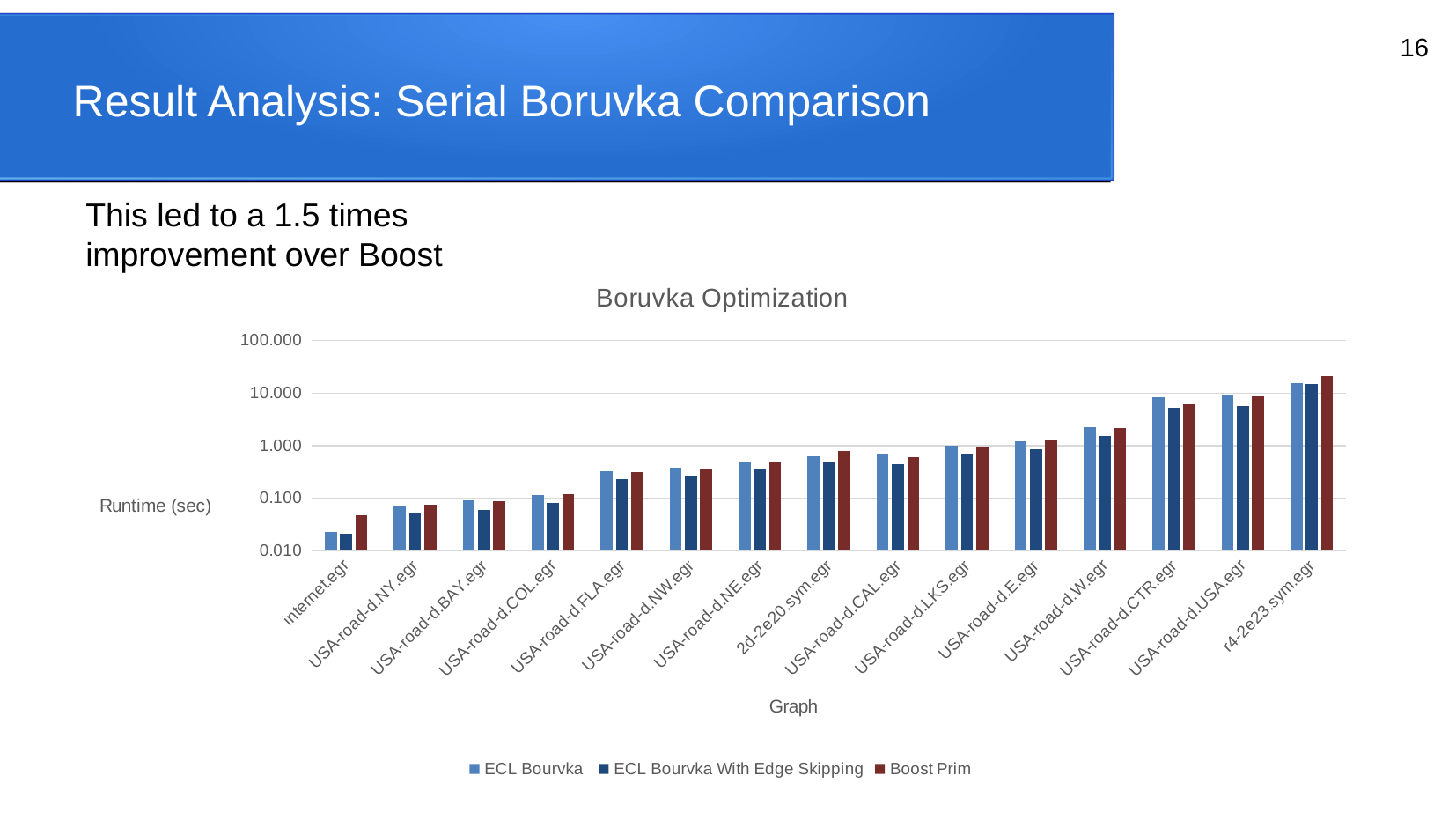
What is the title of the chart? Boruvka Optimization Is the Boost Prim runtime for r4-2e23.sym.egr greater or less than 10.000? greater How many series does the chart legend list? 3 What is the label of the y axis of the chart? Runtime (sec) For USA-road-d.USA.egr, which is larger: the ECL Bourvka runtime or the ECL Bourvka With Edge Skipping runtime? ECL Bourvka Which graph has the highest runtimes in the chart? r4-2e23.sym.egr How many graphs (categories) are shown along the x axis of the chart? 15 Which graph has the lowest runtimes in the chart? internet.egr What kind of chart is shown on the slide? Bar chart Do the runtimes generally rise or fall moving from left to right along the x axis? Rise Is the ECL Bourvka runtime for internet.egr greater or less than 0.100? less Is the ECL Bourvka runtime for USA-road-d.W.egr greater or less than 1.000? greater